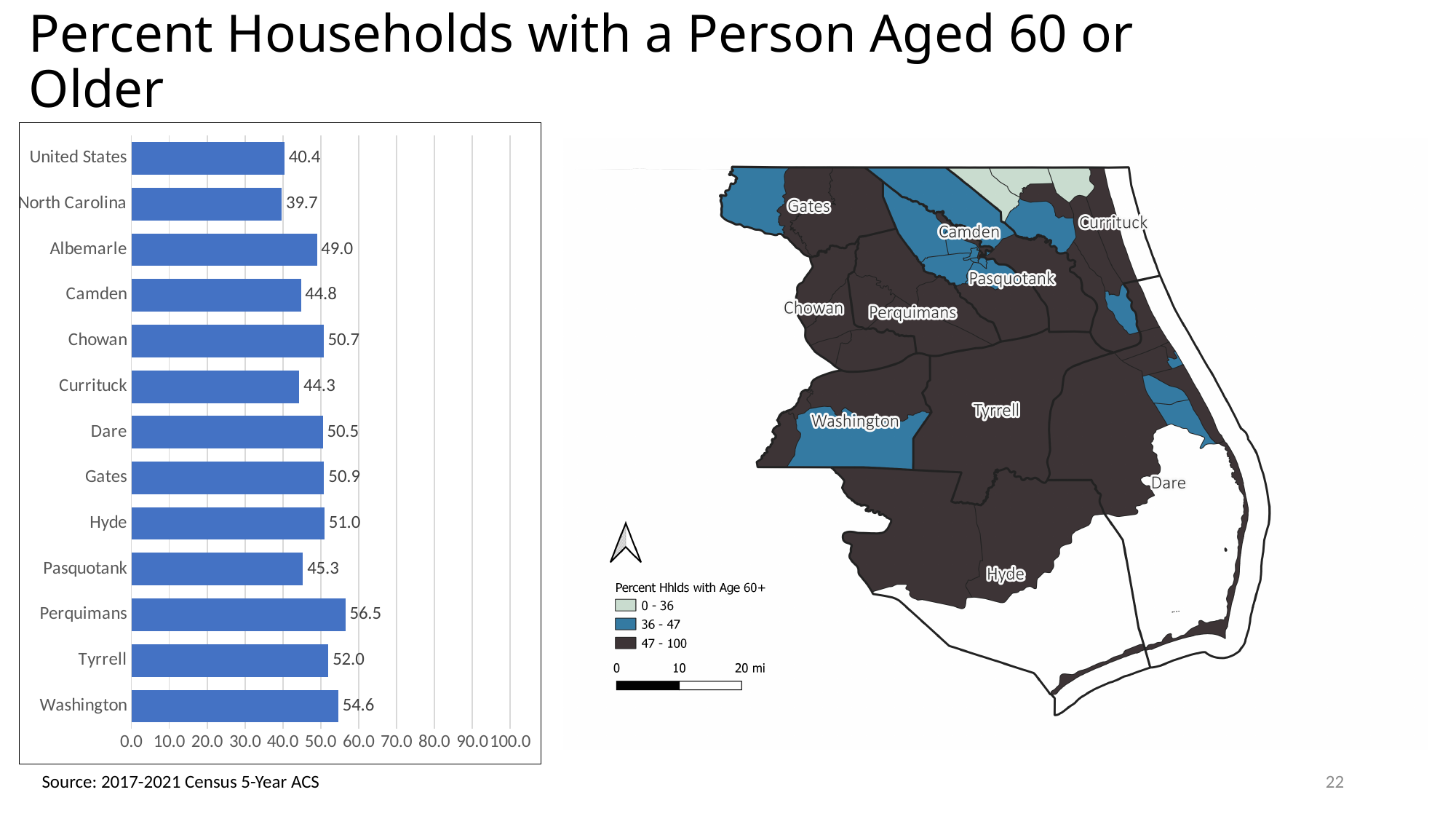
What kind of chart is shown on the left of the slide? bar chart Which category has the highest value in the bar chart? Perquimans What is the value for Camden in the bar chart? 44.8 What is the difference between the values for Perquimans and Washington in the bar chart? 1.9 In the bar chart, is the value for Currituck greater or less than 50.0? less How many categories are shown in the bar chart? 13 What is the value for North Carolina in the bar chart? 39.7 Which category has the lowest value in the bar chart? North Carolina What is the title of the slide? Percent Households with a Person Aged 60 or Older What is the value for Perquimans in the bar chart? 56.5 In the bar chart, which is larger, the value for Washington or the value for Pasquotank? Washington What is the difference between the values for Albemarle and North Carolina in the bar chart? 9.3